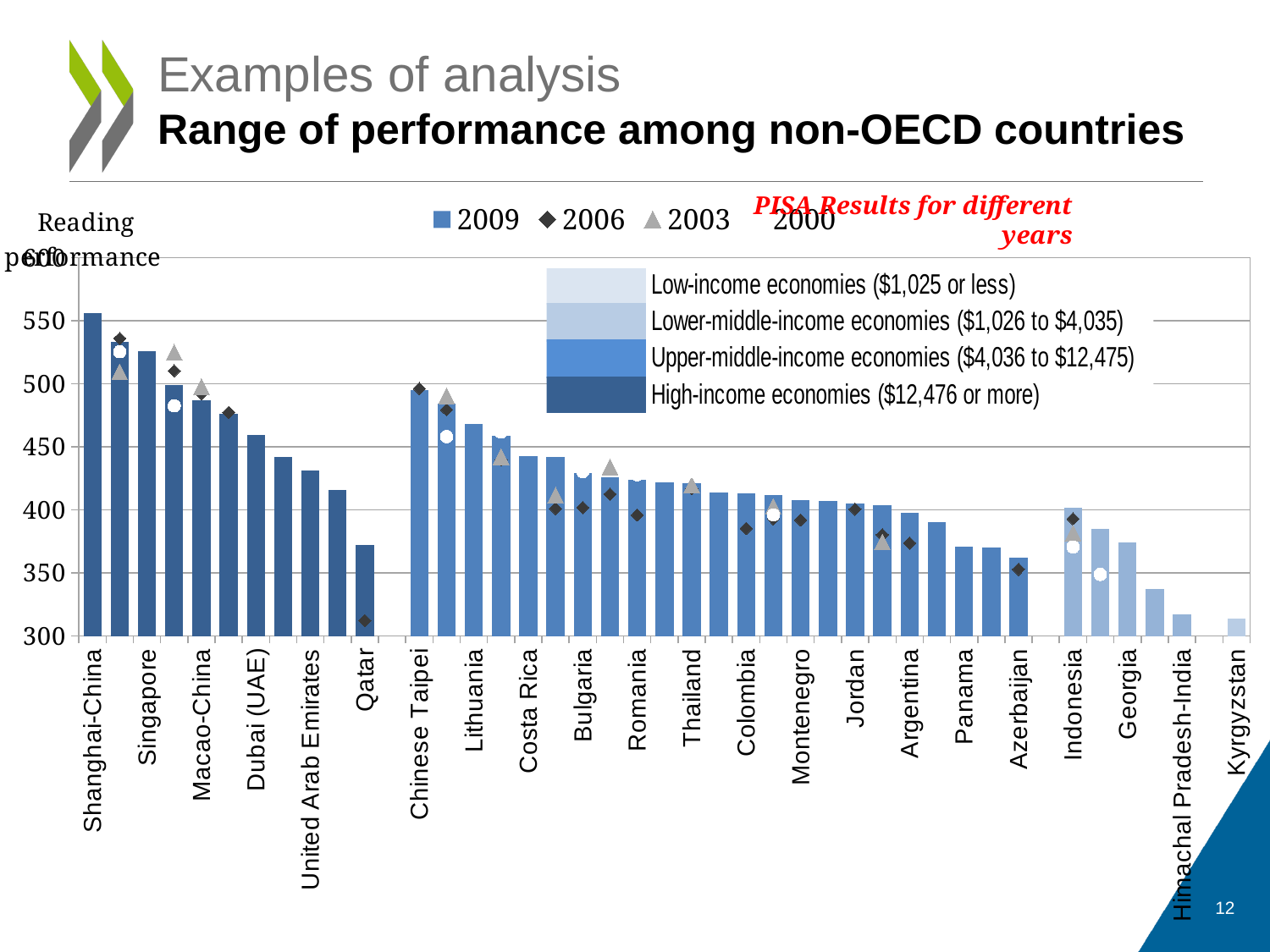
Is the 2009 reading performance value for Azerbaijan greater or less than 400? less Which country has the highest 2009 reading performance bar? Shanghai-China How many series does the legend at the top of the chart list? 4 Is the 2009 reading performance value for Qatar greater or less than 400? less Which has the higher 2009 reading performance bar, Chinese Taipei or Panama? Chinese Taipei Is the 2009 reading performance value for Kyrgyzstan greater or less than 350? less Which has the higher 2009 reading performance bar, Singapore or Georgia? Singapore According to the income-group legend, which income group is shown with the darkest blue bars? High-income economies ($12,476 or more) What kind of chart is shown on the slide? bar chart Which years are listed in the chart legend? 2009, 2006, 2003, 2000